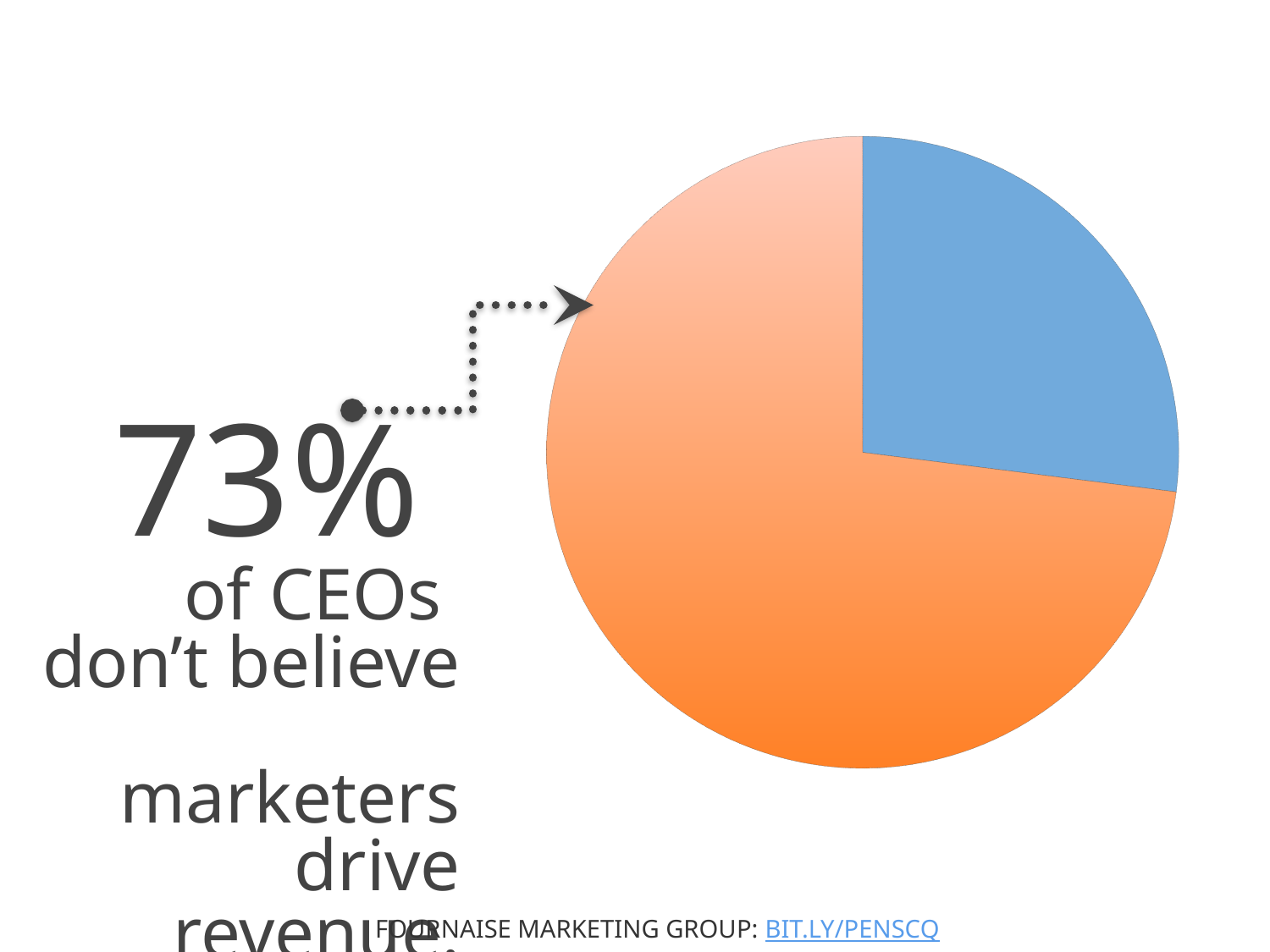
How many slices does the pie chart have? 2 Which is larger, the orange slice or the blue slice? the orange slice Which slice of the pie chart is the largest? the orange slice What source is cited for the pie chart data? Fournaise Marketing Group What does the 73% slice of the pie chart represent, according to the slide text? CEOs who don't believe marketers drive revenue What kind of chart is shown on the slide? pie chart Does the orange slice cover more or less than half of the pie? more Which slice of the pie chart is the smallest? the blue slice What share of the pie does the orange slice represent? 73% What share of the pie does the blue slice represent? 27%